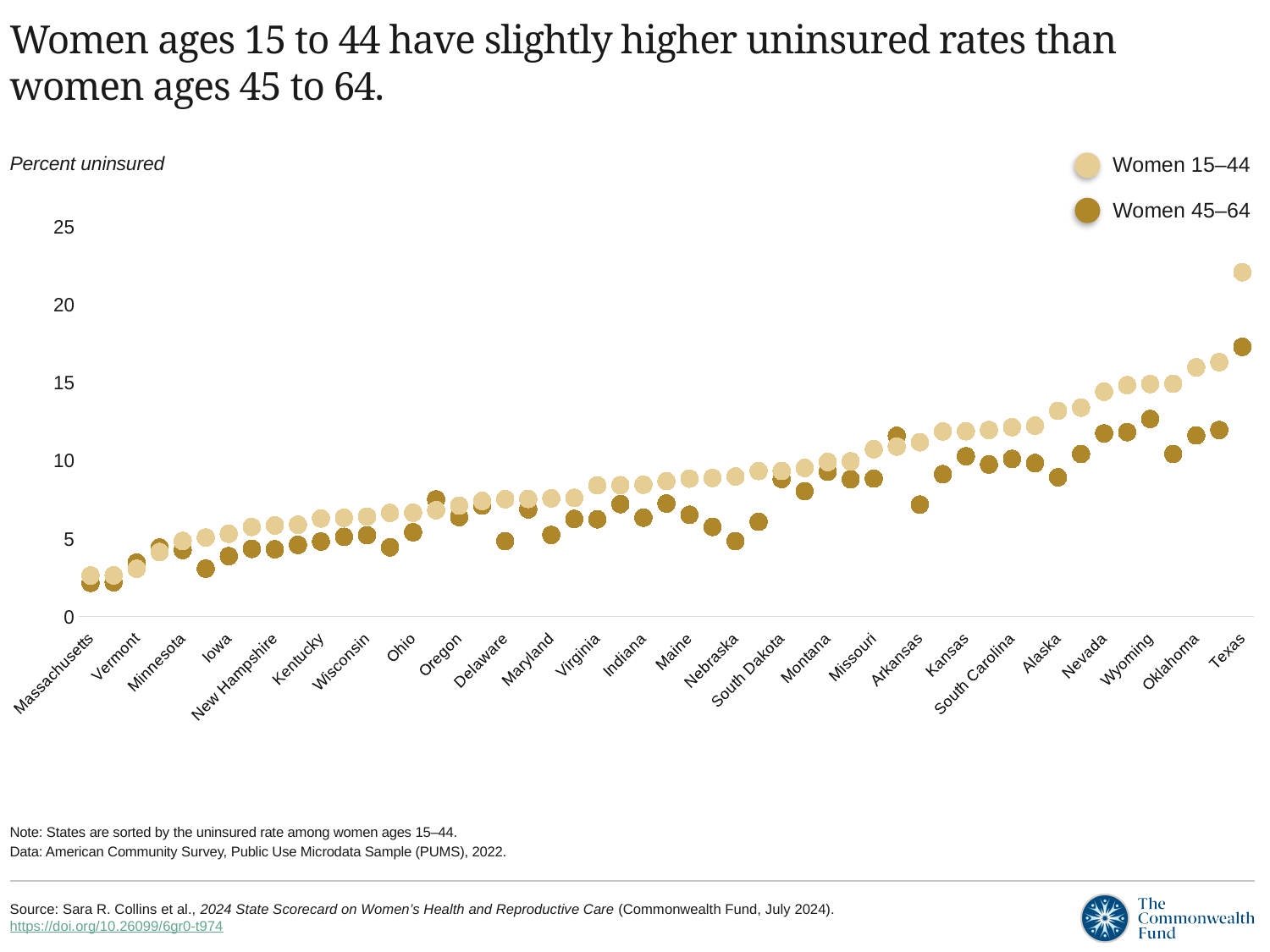
Is the value for Women 15–44 in Kansas greater or less than 10? greater Is the value for Women 45–64 in Texas greater or less than 15? greater What kind of chart is shown on the slide? Dot (scatter) chart Which state has the lowest uninsured rate for Women 15–44? Massachusetts In Nebraska, which series has the larger value, Women 15–44 or Women 45–64? Women 15–44 How many series does the legend list? 2 Is the value for Women 15–44 in Vermont greater or less than 5? less Which state has the highest uninsured rate for Women 45–64? Texas What are the two series named in the legend? Women 15–44 and Women 45–64 Which state has the highest uninsured rate for Women 15–44? Texas Do the Women 15–44 values rise or fall moving from left to right along the x axis? rise